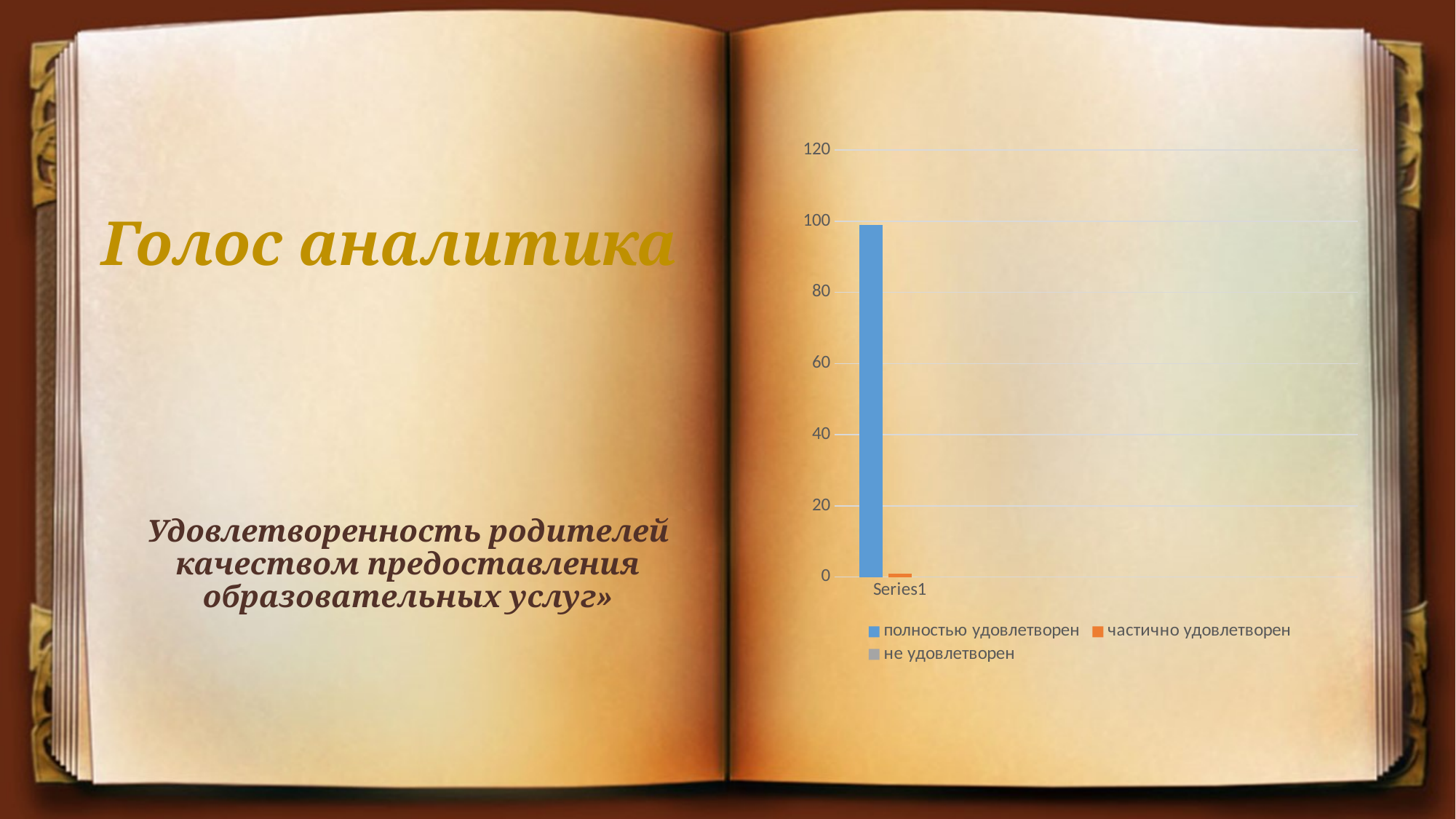
Which series has the tallest bar in the chart? полностью удовлетворен How many categories are shown on the x axis of the chart? 1 Is the value for "частично удовлетворен" greater or less than 20? less What is the label of the single category on the x axis of the chart? Series1 How many series does the chart's legend list? 3 What is the highest value shown on the vertical axis of the chart? 120 What kind of chart is shown on the right page of the slide? bar chart What colour is the bar for "частично удовлетворен" in the chart? orange Which is larger, the value for "полностью удовлетворен" or the value for "частично удовлетворен"? полностью удовлетворен Is the value for "полностью удовлетворен" greater or less than 80? greater